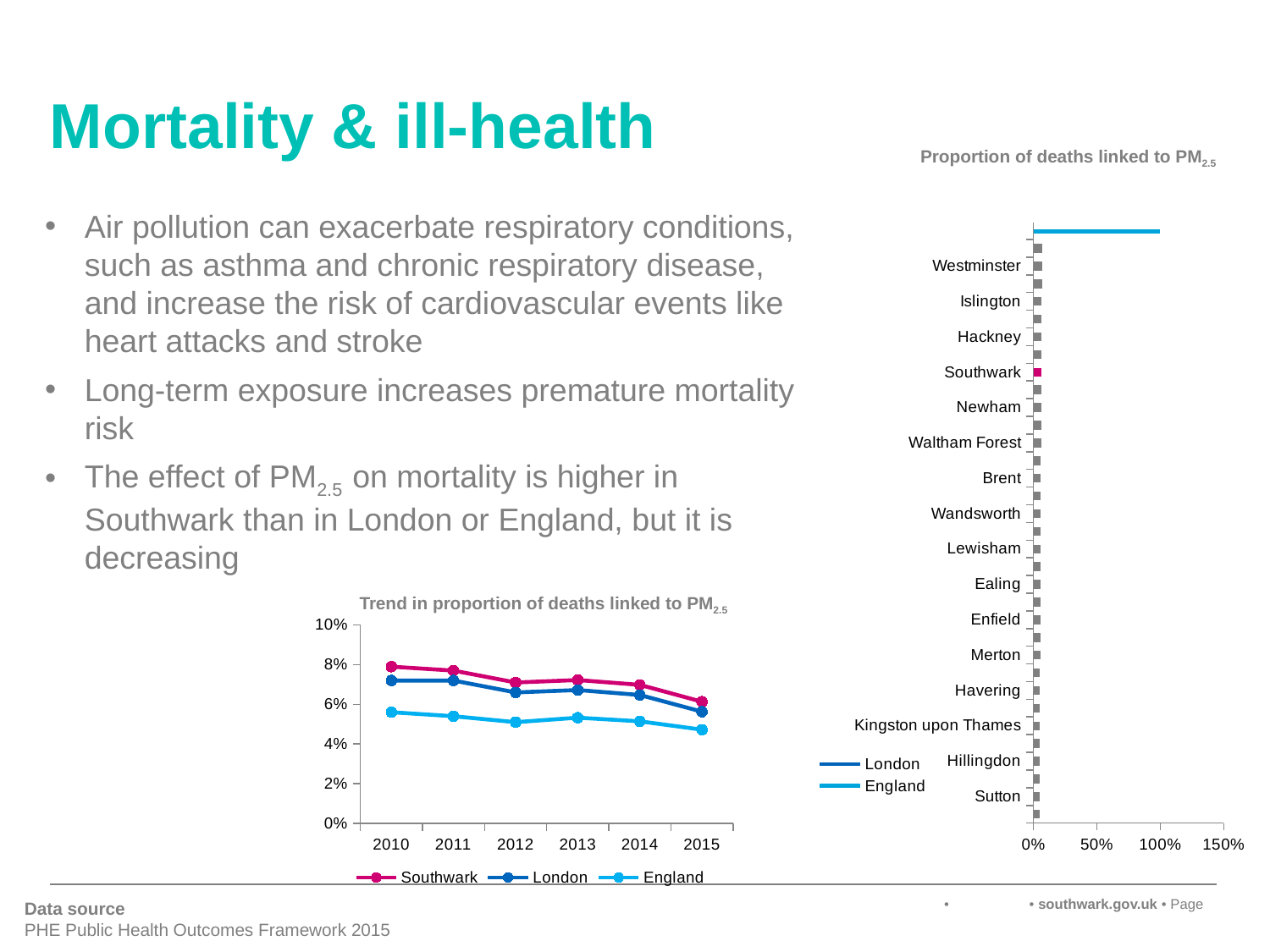
In the 'Trend in proportion of deaths linked to PM2.5' chart, which series has the lowest value in 2015? England How many series does the legend of the 'Trend in proportion of deaths linked to PM2.5' chart list? 3 In the 'Trend in proportion of deaths linked to PM2.5' chart, does the Southwark series rise or fall from 2010 to 2015? fall In the 'Trend in proportion of deaths linked to PM2.5' chart, is the London value for 2010 greater or less than 6%? greater How many years are plotted on the x axis of the 'Trend in proportion of deaths linked to PM2.5' chart? 6 In the 'Proportion of deaths linked to PM2.5' bar chart on the right, which borough's bar is highlighted in pink? Southwark What kind of chart is the 'Proportion of deaths linked to PM2.5' chart on the right of the slide? bar chart What kind of chart is the 'Trend in proportion of deaths linked to PM2.5' chart? line chart In the 'Trend in proportion of deaths linked to PM2.5' chart, which series has the highest value in 2010? Southwark In the 'Trend in proportion of deaths linked to PM2.5' chart, which is larger in 2013: Southwark or England? Southwark In the 'Trend in proportion of deaths linked to PM2.5' chart, is the England value for 2015 greater or less than 6%? less In the 'Trend in proportion of deaths linked to PM2.5' chart, is the Southwark value for 2010 greater or less than 6%? greater